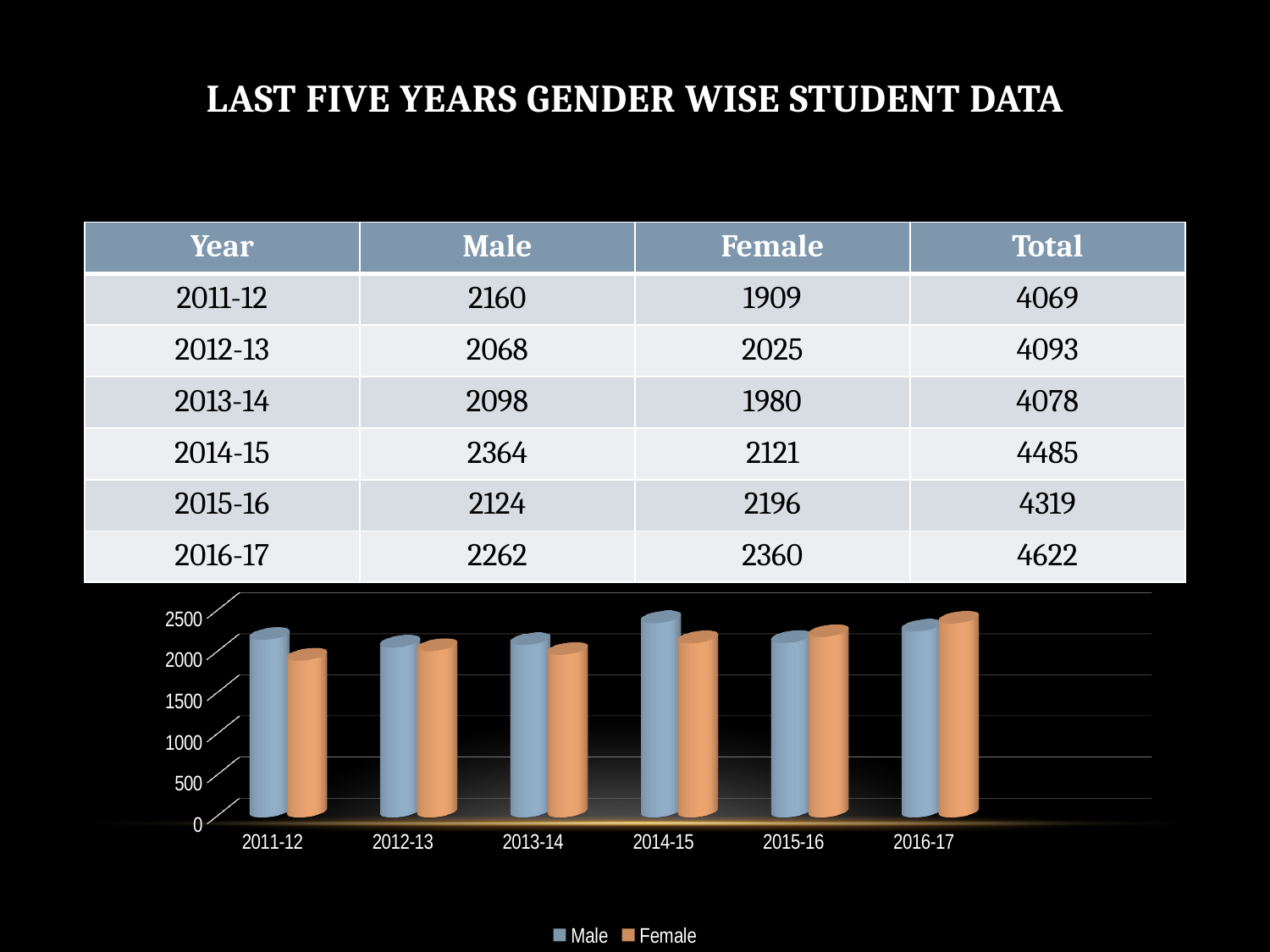
What is the Female value for 2011-12? 1909 What is the Male value for 2014-15? 2364 What is the difference between the Male and Female values in 2014-15? 243 Which year has the lowest Female value? 2011-12 Does the Female value rise or fall from 2013-14 to 2016-17? rise What kind of chart is shown on the slide? bar chart Which is larger in 2016-17, the Male value or the Female value? Female How many year categories are shown on the x axis of the chart? 6 Is the Female value for 2011-12 greater or less than 2000? less How many series does the chart legend list? 2 Which year has the highest Male value? 2014-15 What colour are the Female bars in the chart? orange